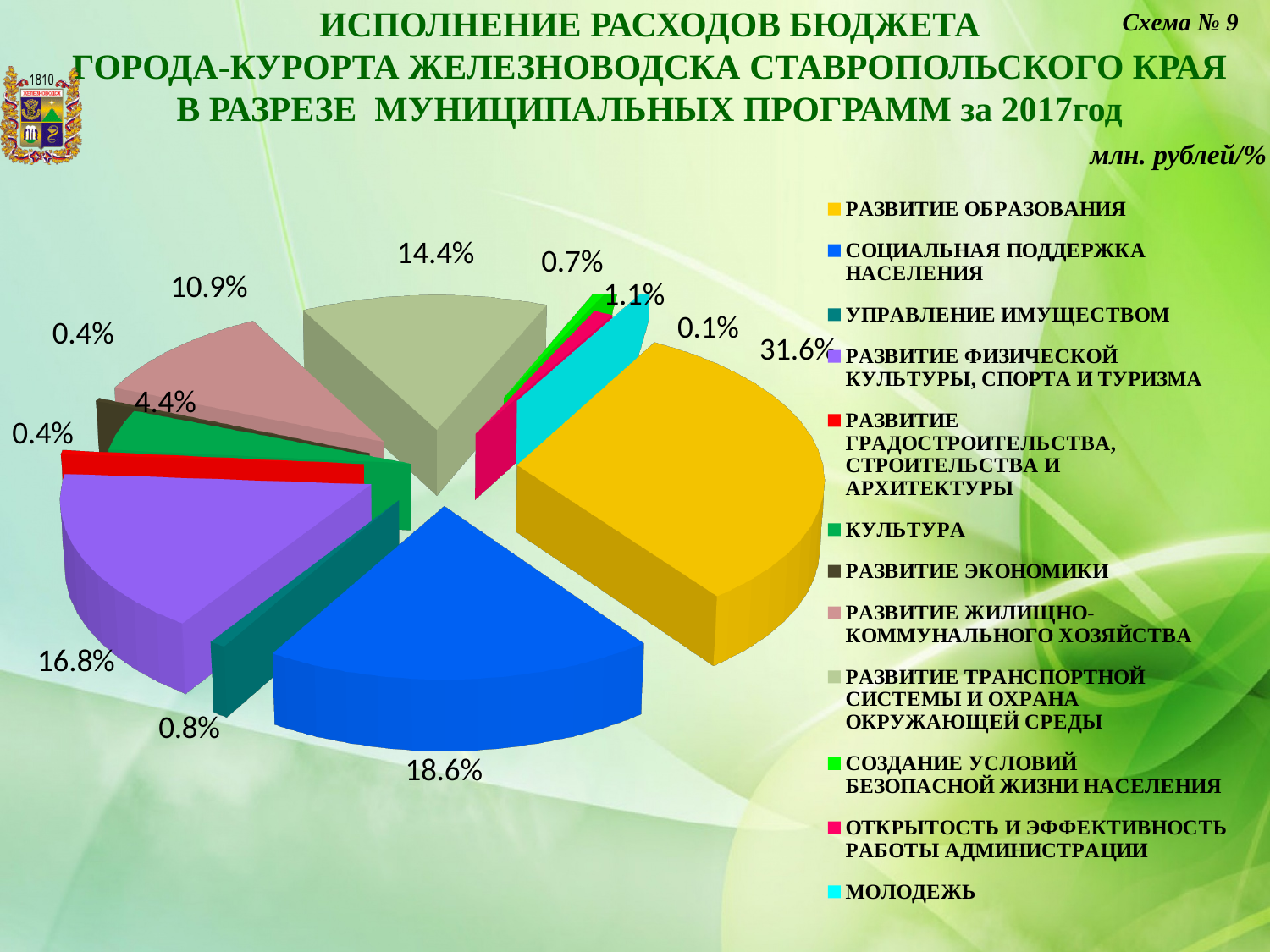
How many categories does the legend of the pie chart list? 12 Which category has the largest share of the pie? РАЗВИТИЕ ОБРАЗОВАНИЯ What is the value shown for РАЗВИТИЕ ФИЗИЧЕСКОЙ КУЛЬТУРЫ, СПОРТА И ТУРИЗМА? 16.8% What is the difference in percentage points between РАЗВИТИЕ ОБРАЗОВАНИЯ and СОЦИАЛЬНАЯ ПОДДЕРЖКА НАСЕЛЕНИЯ? 13.0 What is the value shown for РАЗВИТИЕ ТРАНСПОРТНОЙ СИСТЕМЫ И ОХРАНА ОКРУЖАЮЩЕЙ СРЕДЫ? 14.4% What share of the pie does РАЗВИТИЕ ОБРАЗОВАНИЯ have? 31.6% What share of the pie does СОЦИАЛЬНАЯ ПОДДЕРЖКА НАСЕЛЕНИЯ have? 18.6% What is the value shown for КУЛЬТУРА? 4.4% What colour is the slice for РАЗВИТИЕ ОБРАЗОВАНИЯ? Yellow Which is larger: the share for СОЦИАЛЬНАЯ ПОДДЕРЖКА НАСЕЛЕНИЯ or for РАЗВИТИЕ ФИЗИЧЕСКОЙ КУЛЬТУРЫ, СПОРТА И ТУРИЗМА? СОЦИАЛЬНАЯ ПОДДЕРЖКА НАСЕЛЕНИЯ What kind of chart is shown on the slide? Pie chart What is the value shown for РАЗВИТИЕ ЖИЛИЩНО-КОММУНАЛЬНОГО ХОЗЯЙСТВА? 10.9%